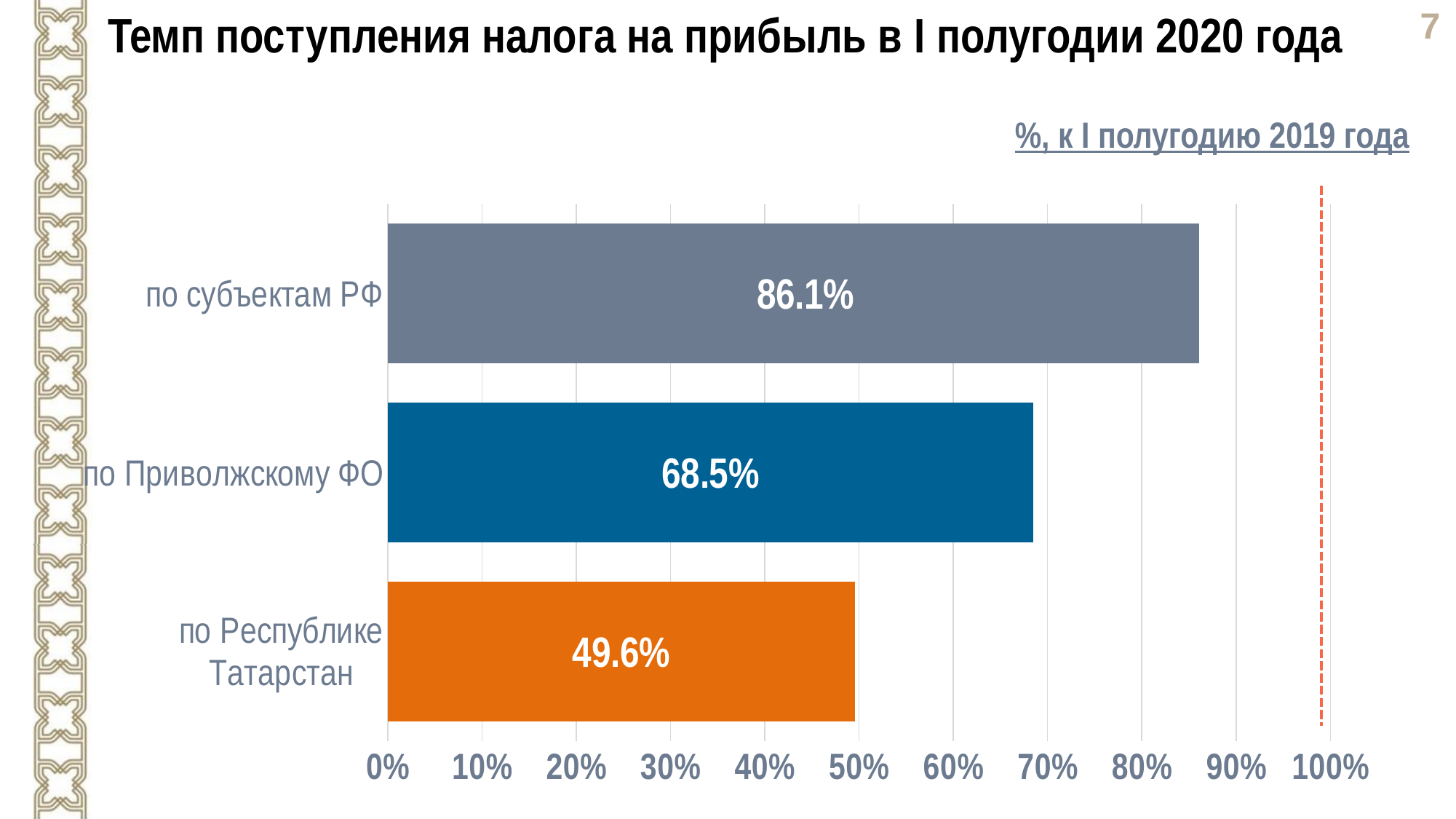
What is the difference between the values for по субъектам РФ and по Республике Татарстан? 36.5% Which is larger, the value for по Приволжскому ФО or the value for по Республике Татарстан? по Приволжскому ФО How many categories are shown in the chart? 3 What is the value for по Республике Татарстан? 49.6% What is the value for по субъектам РФ? 86.1% Which category has the lowest value? по Республике Татарстан What is the title of the chart? Темп поступления налога на прибыль в I полугодии 2020 года What kind of chart is shown on the slide? bar chart What is the difference between the values for по Приволжскому ФО and по Республике Татарстан? 18.9% Is the value for по субъектам РФ greater or less than 80%? greater What is the value for по Приволжскому ФО? 68.5% Which category has the highest value? по субъектам РФ